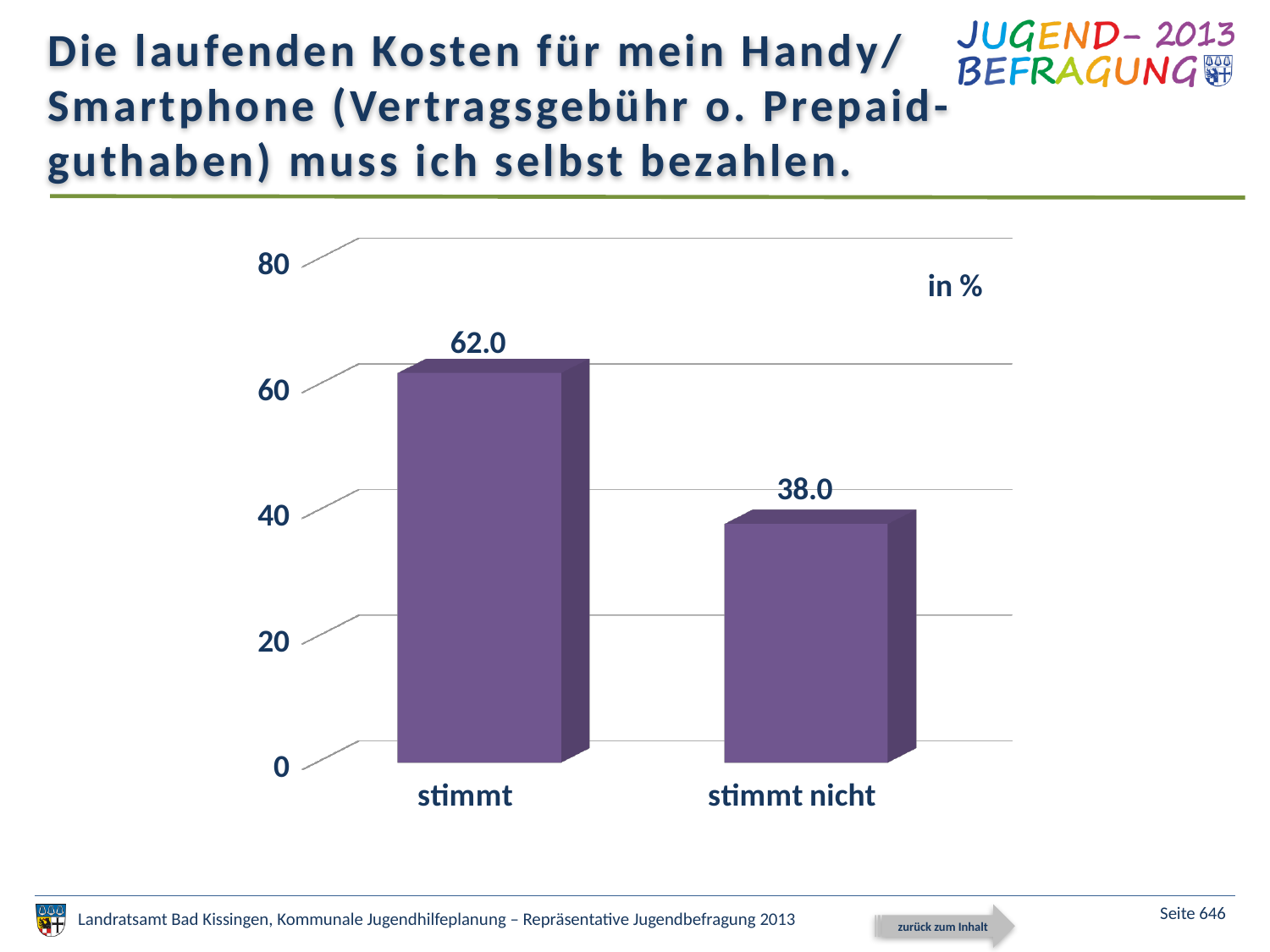
Which is larger, the value for "stimmt" or for "stimmt nicht"? stimmt What is the value for "stimmt"? 62.0 What is the highest tick value shown on the vertical axis? 80 Is the value for "stimmt" greater or less than 60? greater How many categories are shown on the x axis? 2 What is the difference between the values for "stimmt" and "stimmt nicht"? 24.0 What is the value for "stimmt nicht"? 38.0 Which category has the highest value? stimmt What kind of chart is shown on the slide? bar chart Is the value for "stimmt nicht" greater or less than 40? less What unit is indicated for the values in the chart? in % Which category has the lowest value? stimmt nicht